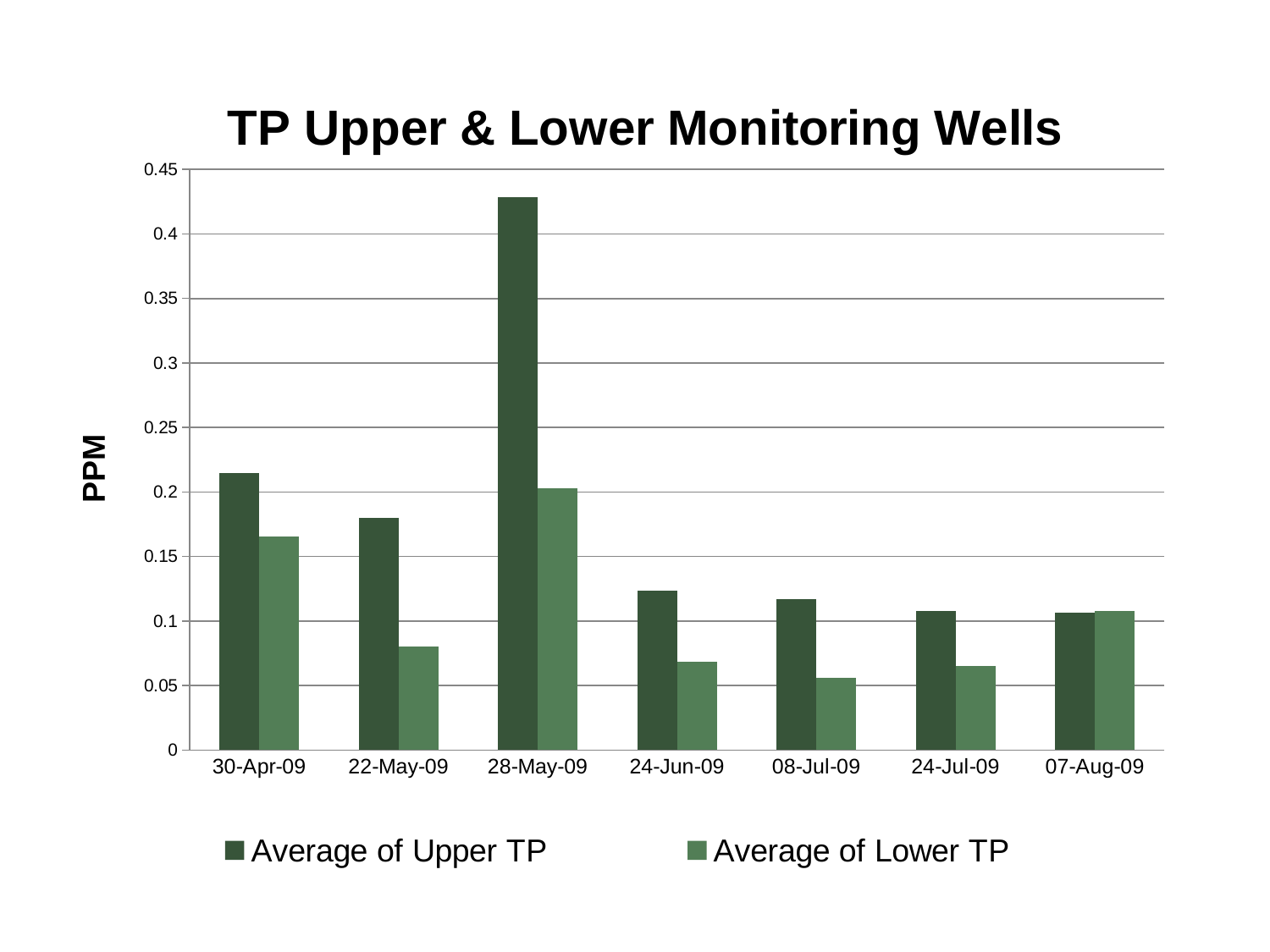
On which date is the Average of Upper TP highest? 28-May-09 On which date is the Average of Lower TP lowest? 08-Jul-09 On 30-Apr-09, which is larger: the Average of Upper TP or the Average of Lower TP? Average of Upper TP Does the Average of Upper TP rise or fall from 28-May-09 to 07-Aug-09? fall What type of chart is shown on the slide? bar chart Is the Average of Upper TP on 30-Apr-09 greater or less than 0.2? greater On which date is the Average of Lower TP highest? 28-May-09 Is the Average of Upper TP on 28-May-09 greater or less than 0.4? greater Is the Average of Lower TP on 22-May-09 greater or less than 0.1? less How many series does the legend list? 2 How many dates are shown on the x axis? 7 What is the label on the vertical axis? PPM